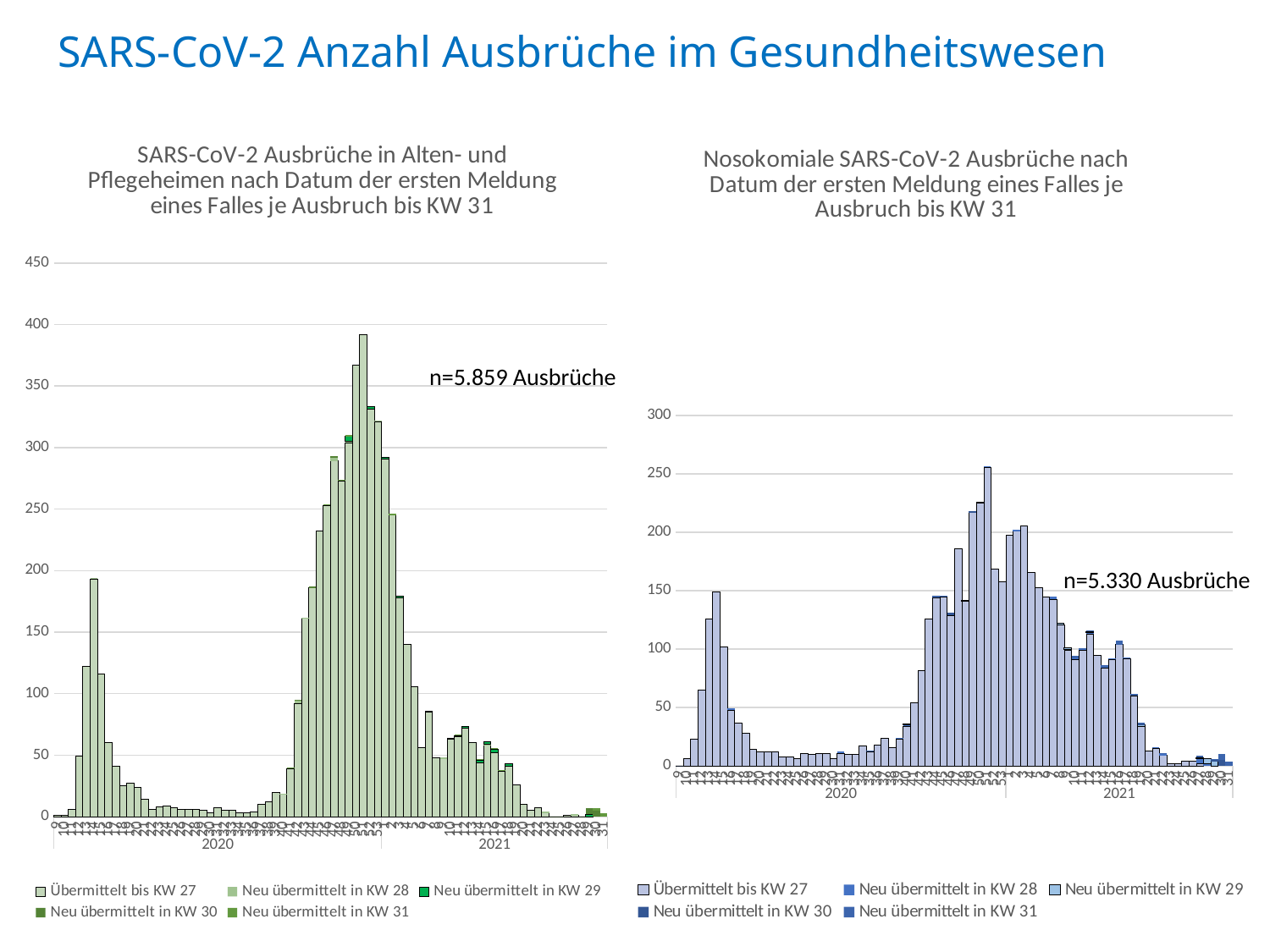
What total number of outbreaks (n) is annotated on the left chart, 'SARS-CoV-2 Ausbrüche in Alten- und Pflegeheimen'? n=5.859 Ausbrüche In the right chart, 'Nosokomiale SARS-CoV-2 Ausbrüche', is the highest bar greater or less than 200? greater In the left chart, 'SARS-CoV-2 Ausbrüche in Alten- und Pflegeheimen', do the values rise or fall from the peak at the end of 2020 toward the last weeks of 2021 shown? fall What total number of outbreaks (n) is annotated on the right chart, 'Nosokomiale SARS-CoV-2 Ausbrüche'? n=5.330 Ausbrüche What is the first legend entry of the right chart, 'Nosokomiale SARS-CoV-2 Ausbrüche'? Übermittelt bis KW 27 Which chart reports the larger total number of outbreaks, the left chart on Alten- und Pflegeheime or the right chart on nosokomiale Ausbrüche? the left chart (Alten- und Pflegeheime) In the left chart, 'SARS-CoV-2 Ausbrüche in Alten- und Pflegeheimen', is the highest bar greater or less than 350? greater What kind of chart is the left chart, 'SARS-CoV-2 Ausbrüche in Alten- und Pflegeheimen'? bar chart What is the highest value shown on the vertical axis of the right chart, 'Nosokomiale SARS-CoV-2 Ausbrüche'? 300 What is the difference between the annotated totals of the left chart (n=5.859) and the right chart (n=5.330)? 529 How many series does the legend of the left chart, 'SARS-CoV-2 Ausbrüche in Alten- und Pflegeheimen', list? 5 How many series does the legend of the right chart, 'Nosokomiale SARS-CoV-2 Ausbrüche', list? 5